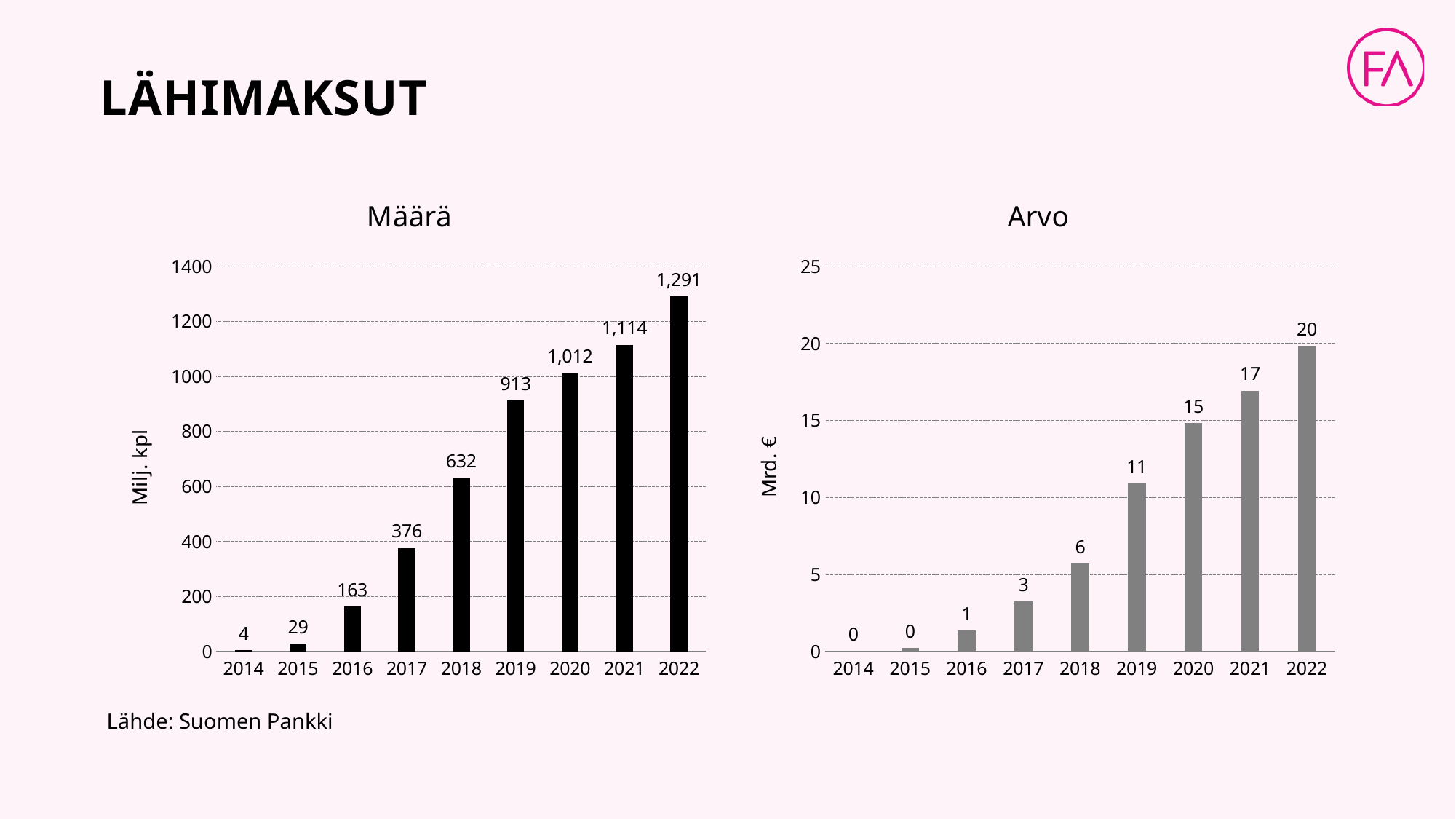
In the Määrä chart, which is larger, the value for 2017 or the value for 2018? 2018 In the Arvo chart, do the values rise or fall from 2014 to 2022? rise How many years are shown on the x axis of the Arvo chart? 9 In the Määrä chart, what is the value for 2019? 913 In the Määrä chart, what is the difference between the values for 2021 and 2020? 102 What kind of chart is the Määrä chart? bar chart In the Määrä chart, is the value for 2020 greater or less than 1000? greater In the Arvo chart, what is the value for 2020? 15 In the Määrä chart, which year has the lowest value? 2014 In the Määrä chart, what is the value for 2022? 1,291 In the Arvo chart, what is the difference between the values for 2022 and 2019? 9 In the Arvo chart, which year has the highest value? 2022